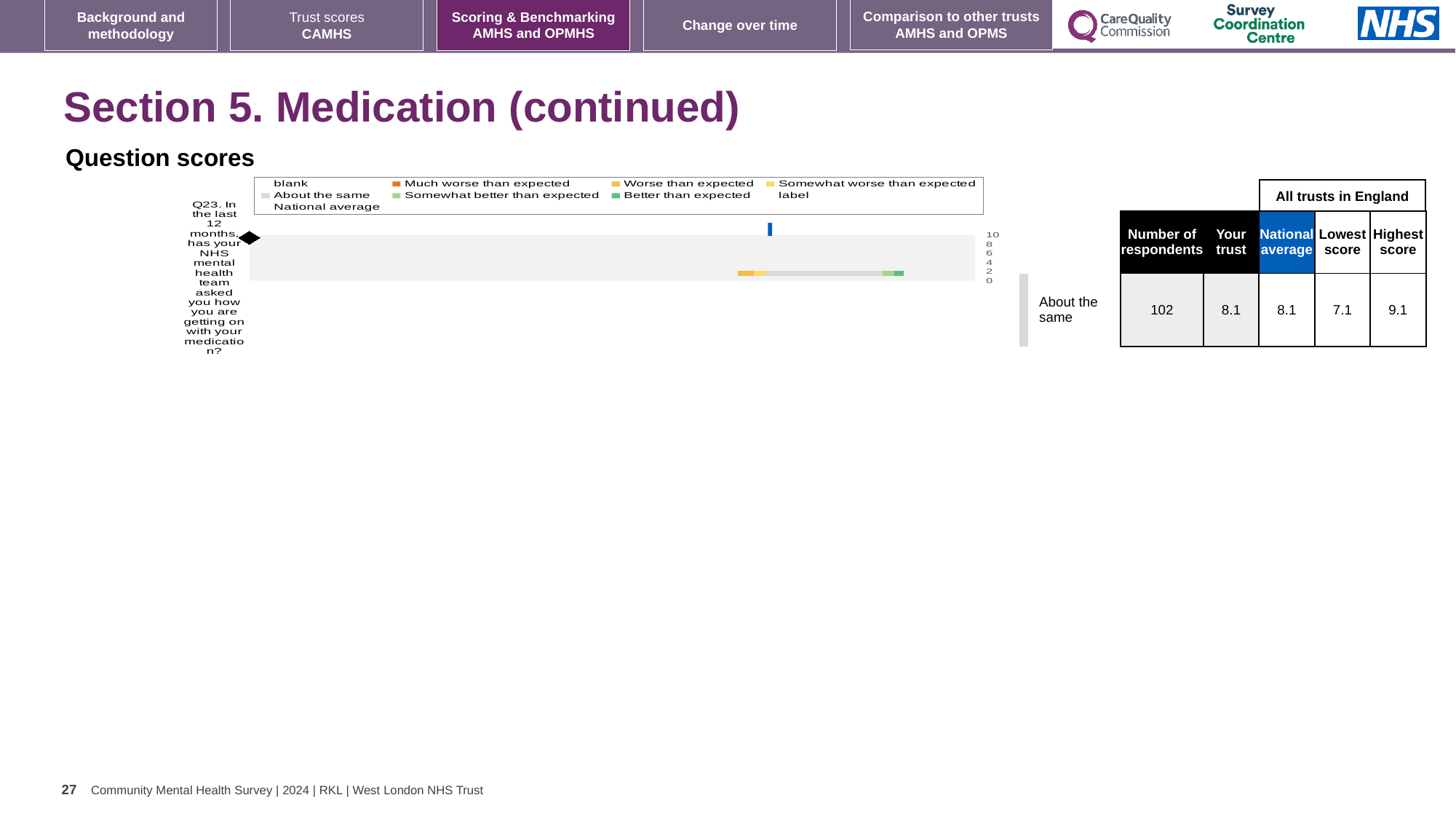
What kind of chart is shown under 'Question scores'? bar chart Which is larger for Q23: the highest score among all trusts or the 'Your trust' score? the highest score among all trusts How many respondents answered Q23, according to the table beside the chart? 102 Which question number is plotted in the Question scores chart? Q23 According to the table beside the chart, what is the national average score for Q23? 8.1 What is the difference between the highest score (9.1) and the lowest score (7.1) for Q23? 2.0 According to the table beside the chart, what is the highest score among all trusts in England for Q23? 9.1 How many questions (categories) are plotted in the Question scores chart? 1 According to the table beside the chart, what is the lowest score among all trusts in England for Q23? 7.1 According to the table beside the chart, what is the 'Your trust' score for Q23? 8.1 What is the highest tick value shown on the axis of the Question scores chart? 10 What benchmark category is the trust's Q23 score placed in, as labelled next to the chart? About the same